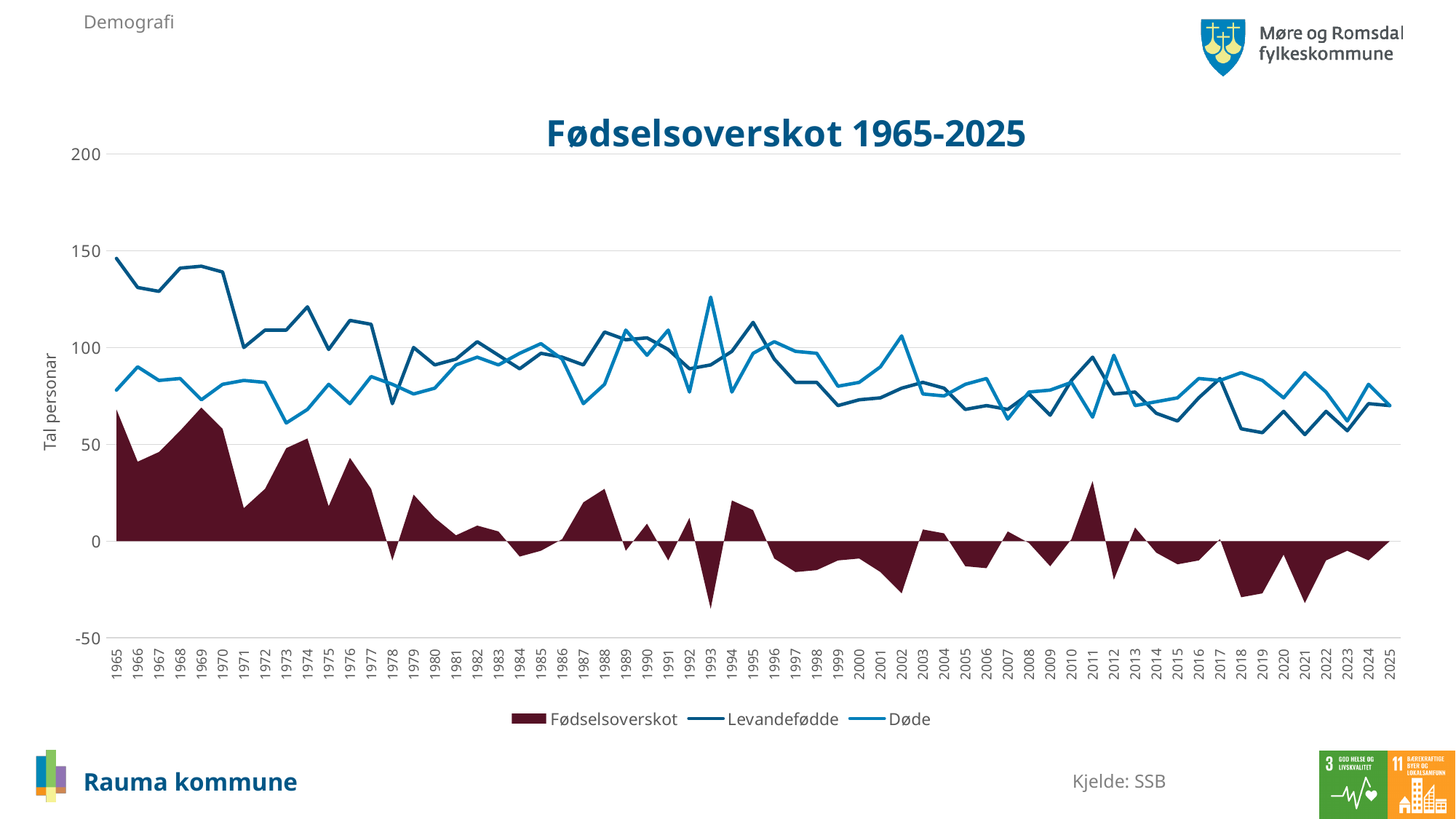
In which year does the Døde series reach its highest value? 1993 What is the title of the chart? Fødselsoverskot 1965-2025 What is the label on the vertical axis of the chart? Tal personar How many series does the chart legend list? 3 Is the value for Døde in 1993 greater or less than 100? greater Does the Levandefødde series generally rise or fall from 1965 to 2025? fall How many years are plotted along the x axis of the chart? 61 In 2019, which is larger: Levandefødde or Døde? Døde Is the value for Fødselsoverskot in 1969 greater or less than 50? greater Is the value for Levandefødde in 1965 greater or less than 100? greater In 1965, which is larger: Levandefødde or Døde? Levandefødde